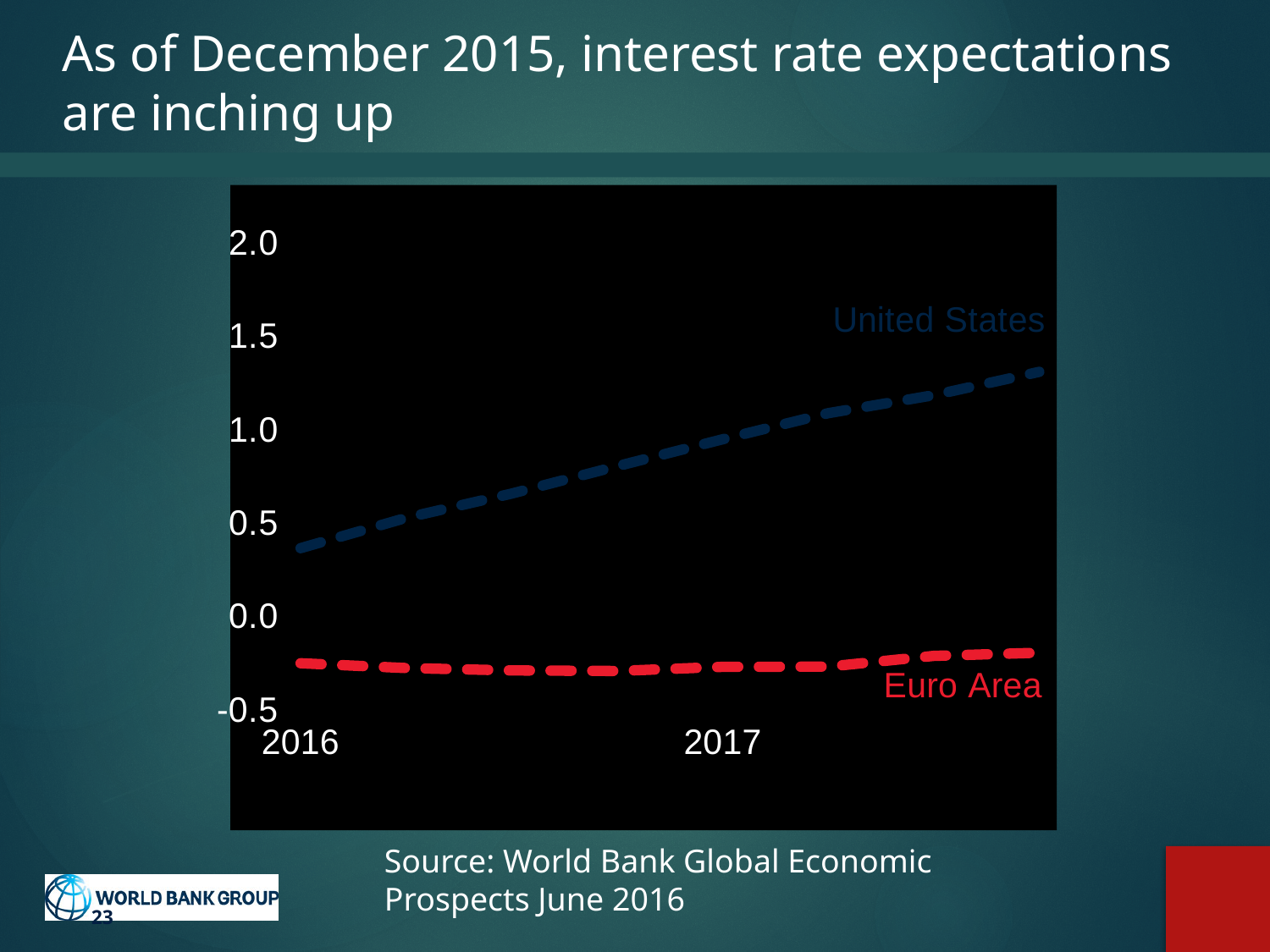
Is the value for the Euro Area at the right end of the chart greater or less than -0.5? greater Does the United States line rise or fall from 2016 to 2017? rise Is the value for the United States at the start of 2016 greater or less than 0.5? less Is the value for the United States at the right end of the chart greater or less than 1.5? less How many series are plotted on the chart? 2 What years are labelled on the x axis? 2016 and 2017 Which two series are labelled on the chart? United States and Euro Area What kind of chart is shown on the slide? line chart Which series is drawn in red? Euro Area Which series has the higher values throughout the chart, United States or Euro Area? United States